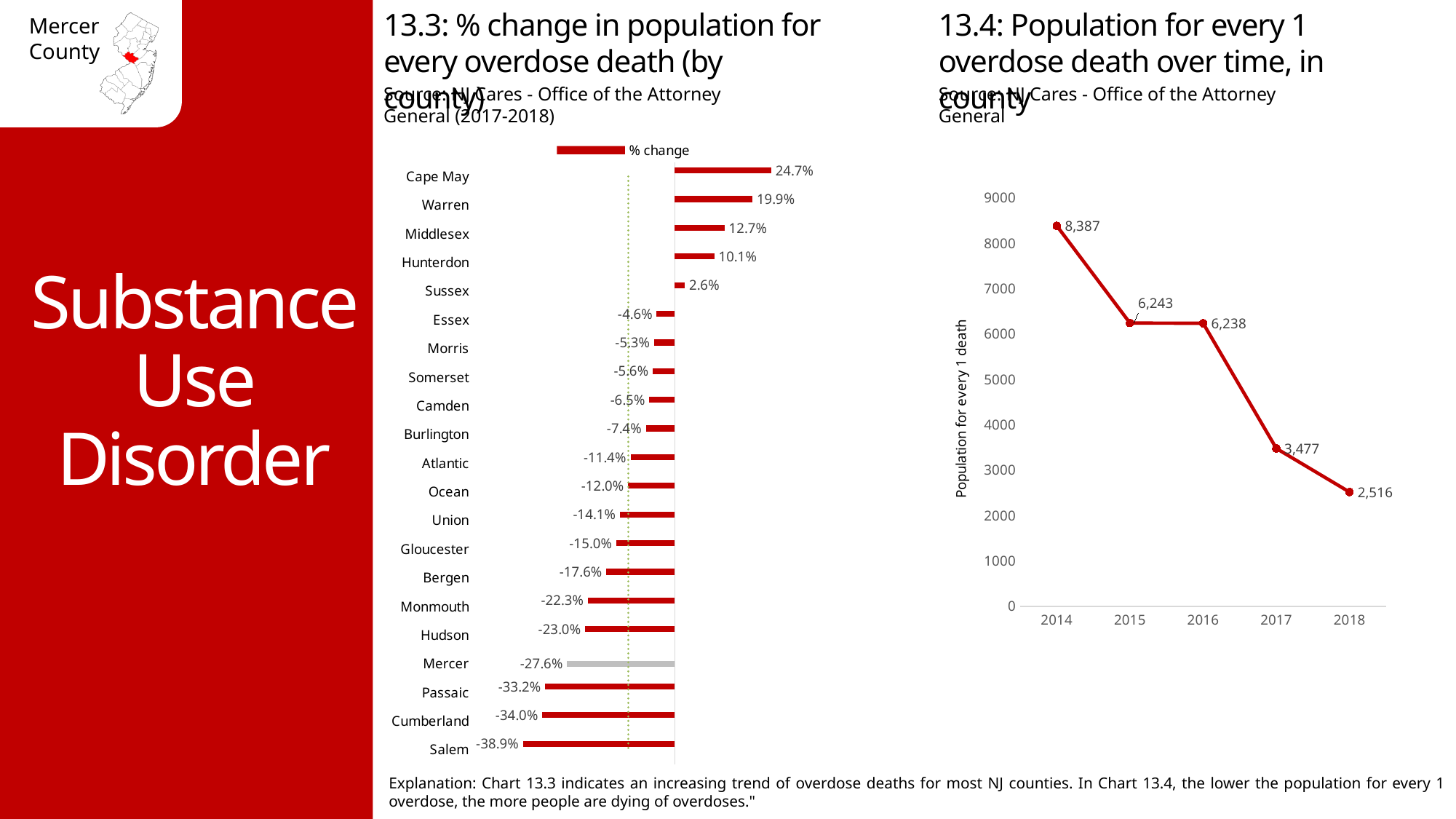
In chart 13.3, which county has the lowest % change? Salem In chart 13.4, do the values rise or fall from 2014 to 2018? Fall What type of chart is chart 13.4? Line chart In chart 13.3, which county has the highest % change? Cape May In chart 13.3, what is the difference in percentage points between Mercer (-27.6%) and Salem (-38.9%)? 11.3 percentage points In chart 13.3, what is the % change for Cape May? 24.7% In chart 13.3, how many counties are shown? 21 In chart 13.3, which has a larger % change, Warren or Middlesex? Warren In chart 13.3, what is the % change for Mercer? -27.6% In chart 13.4, what is the population for every 1 overdose death in 2014? 8,387 In chart 13.4, what is the difference between the 2014 value and the 2018 value? 5,871 In chart 13.4, what is the population for every 1 overdose death in 2018? 2,516